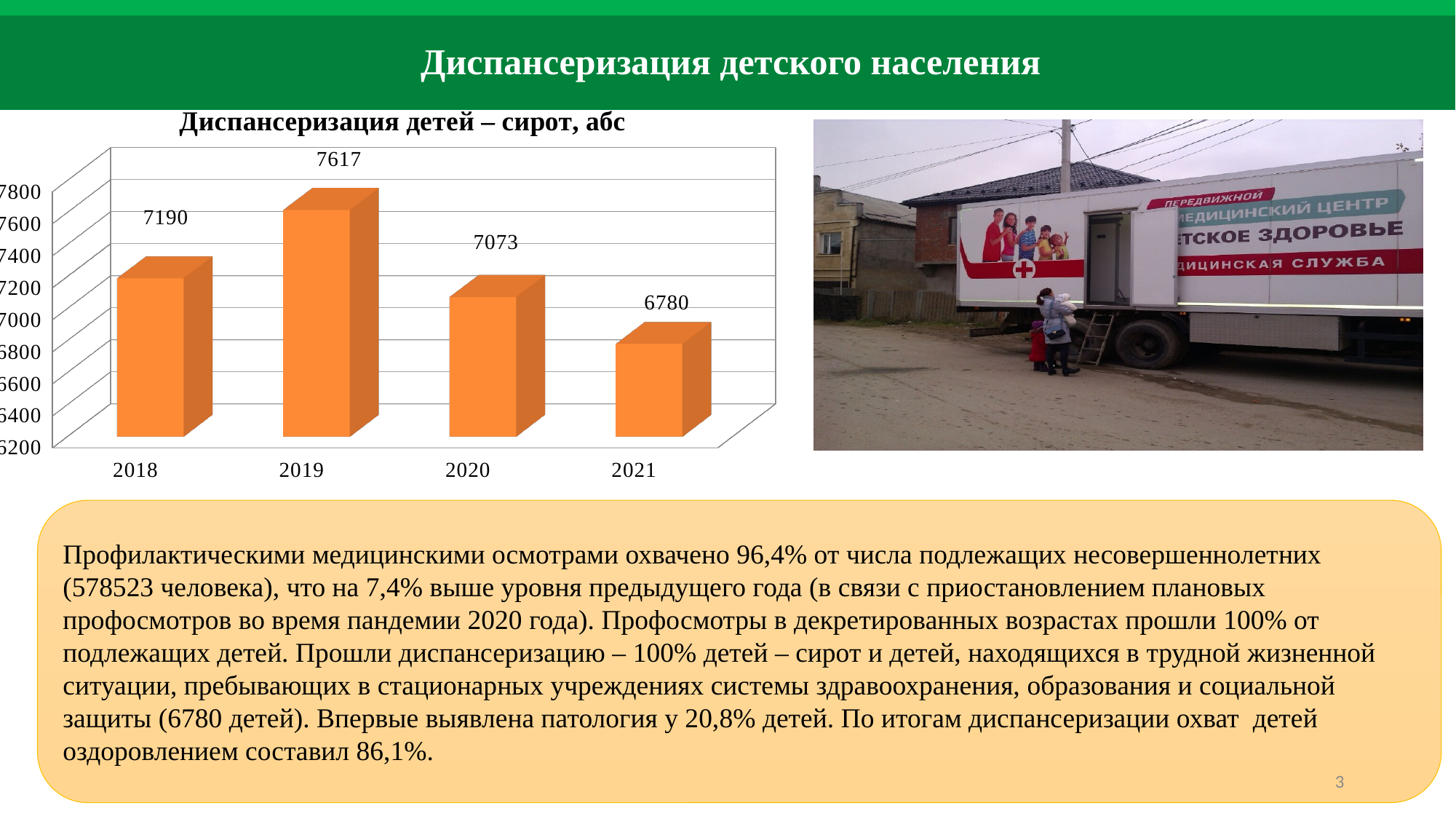
Which is larger, the value for 2018 or the value for 2020? 2018 What is the value for 2018? 7190 What is the value for 2019? 7617 What is the value for 2021? 6780 Which year has the lowest value? 2021 What is the value for 2020? 7073 What is the difference between the values for 2018 and 2020? 117 What is the difference between the values for 2019 and 2021? 837 How many years are shown on the x axis? 4 What kind of chart is shown on the slide? Bar chart What is the title of the chart? Диспансеризация детей – сирот, абс Which year has the highest value? 2019